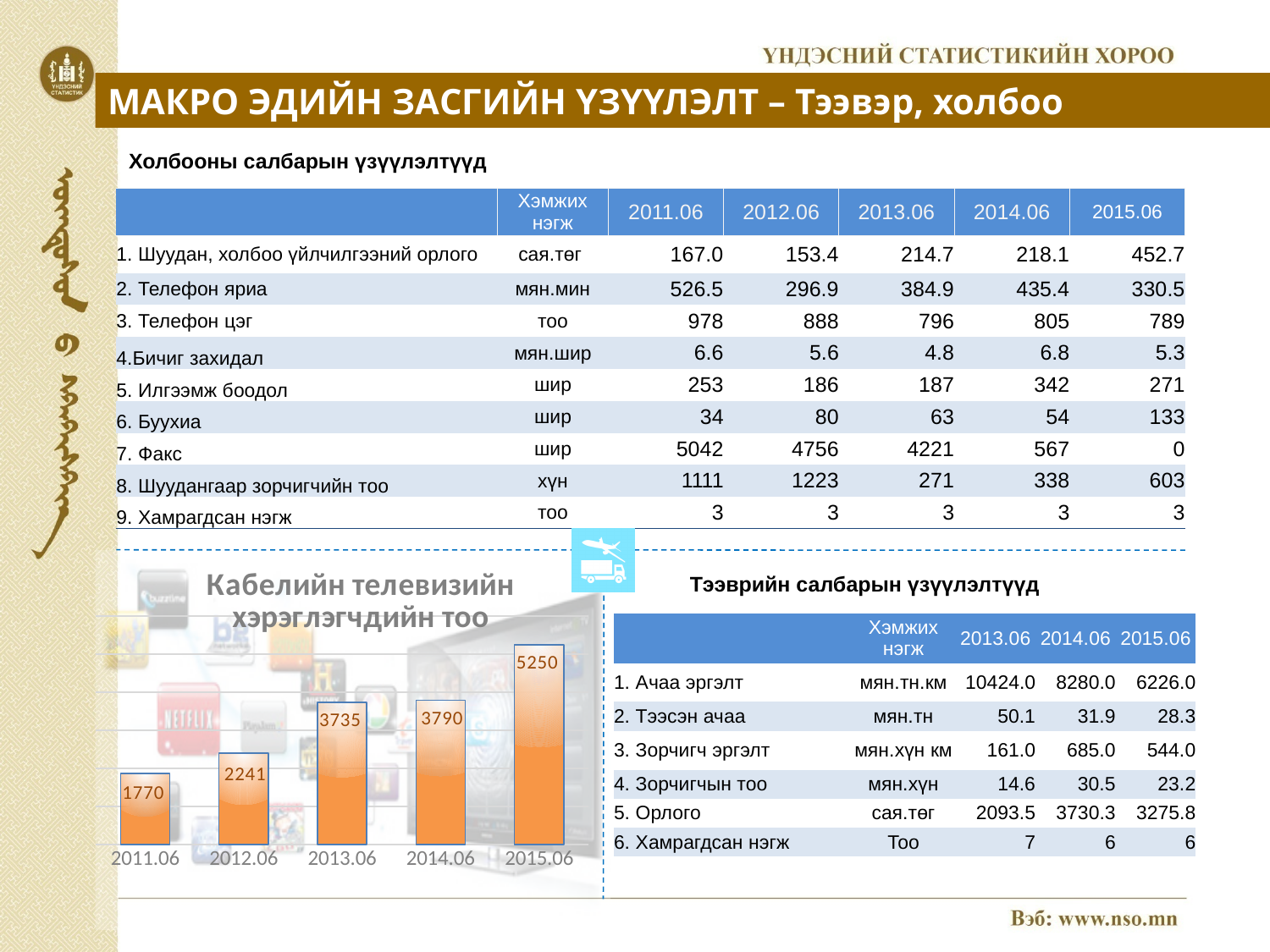
In the cable television subscribers chart, which is larger: the value for 2013.06 or the value for 2012.06? 2013.06 In the cable television subscribers chart, what is the value for 2013.06? 3735 How many periods (bars) are shown in the cable television subscribers chart? 5 In the cable television subscribers chart, what is the difference between the values for 2015.06 and 2014.06? 1460 What type of chart is used to show the number of cable television subscribers (Кабелийн телевизийн хэрэглэгчдийн тоо)? bar chart In the cable television subscribers chart, what is the value for 2012.06? 2241 In the cable television subscribers chart, what is the difference between the values for 2012.06 and 2011.06? 471 In the cable television subscribers chart, which period has the lowest value? 2011.06 Do the values in the cable television subscribers chart rise or fall from 2011.06 to 2015.06? rise In the cable television subscribers chart, what is the value for 2011.06? 1770 In the cable television subscribers chart, what is the value for 2015.06? 5250 In the cable television subscribers chart, which period has the highest value? 2015.06